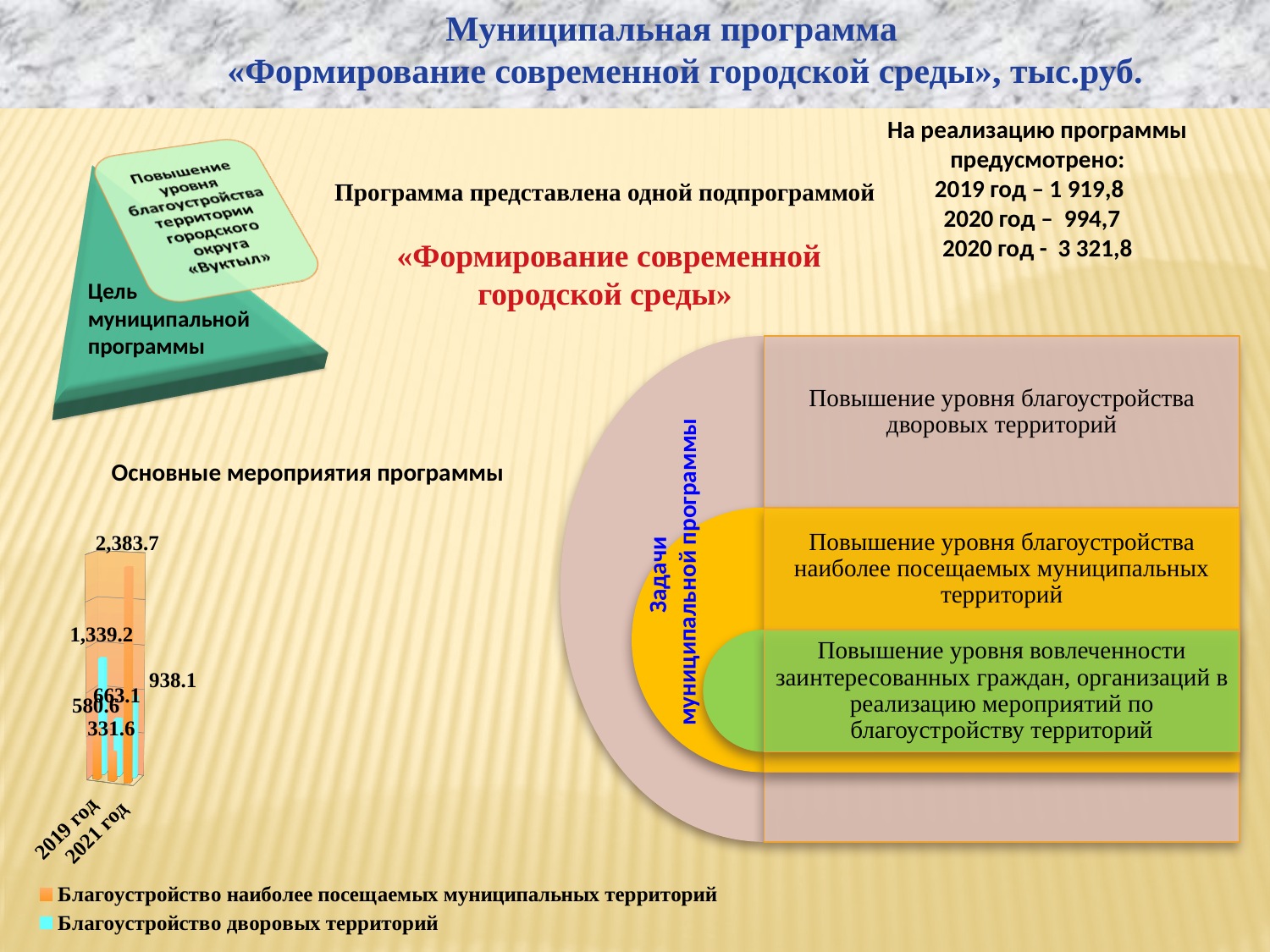
What is the difference between the highest labelled value (2,383.7) and the lowest labelled value (331.6) on the chart? 2,052.1 What is the difference between the labelled values 1,339.2 and 938.1 on the chart? 401.1 Is the highest labelled value on the chart greater or less than 2,000? greater Which series does the tallest bar (2,383.7) on the chart belong to? Благоустройство наиболее посещаемых муниципальных территорий How many series does the legend of the bar chart list? 2 What kind of chart is shown under the heading "Основные мероприятия программы"? bar chart What is the lowest value labelled on the bar chart? 331.6 Which is larger on the chart, the bar labelled 938.1 or the bar labelled 663.1? 938.1 What is the highest value labelled on the bar chart? 2,383.7 Which legend entry is shown in cyan on the bar chart? Благоустройство дворовых территорий Which legend entry is shown in orange on the bar chart? Благоустройство наиболее посещаемых муниципальных территорий